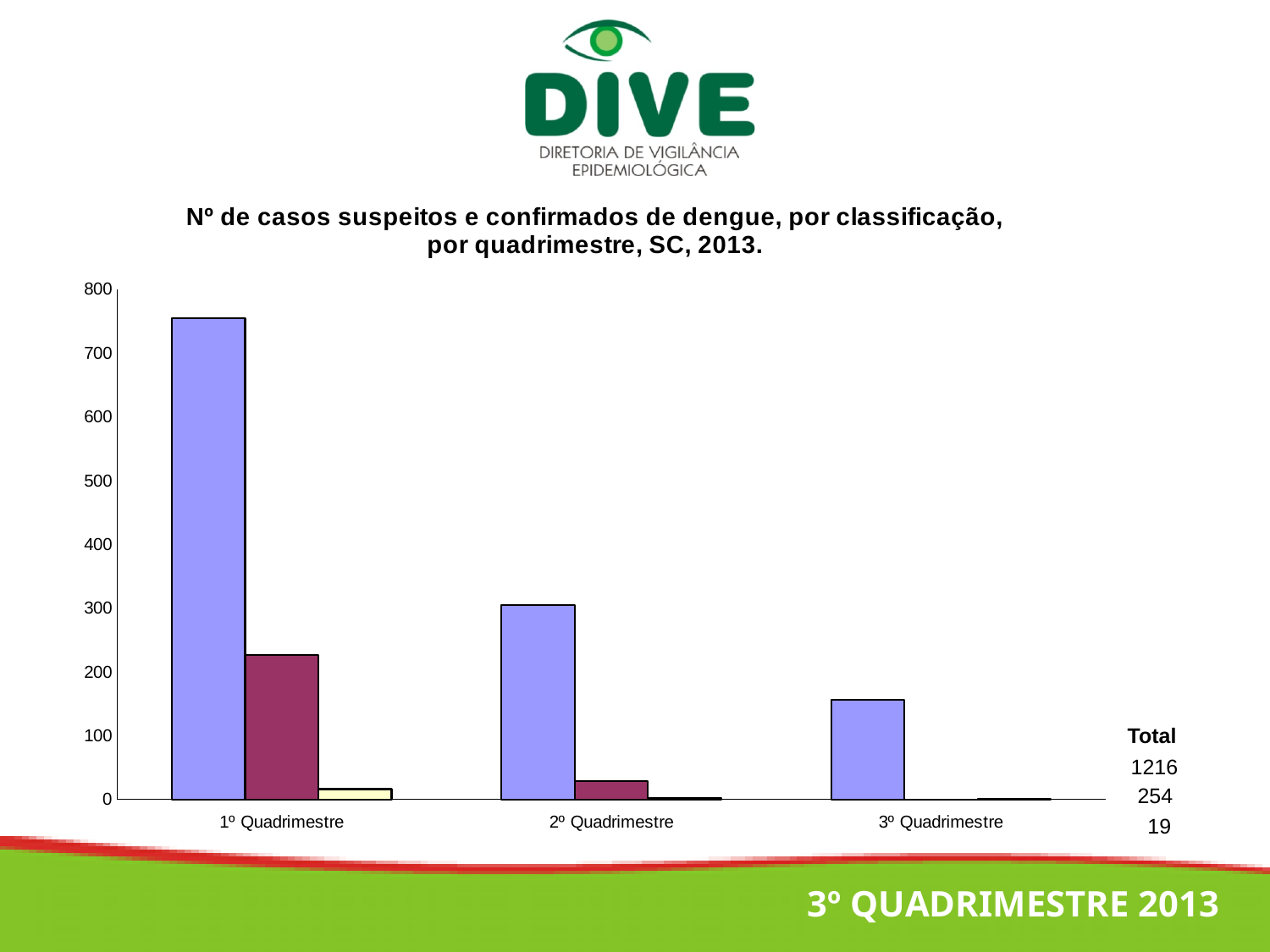
What is the title of the chart? Nº de casos suspeitos e confirmados de dengue, por classificação, por quadrimestre, SC, 2013. Is the value of the blue bar for 3º Quadrimestre greater or less than 200? less How many quadrimestre categories are shown on the x axis? 3 Do the blue bars rise or fall from 1º Quadrimestre to 3º Quadrimestre? fall Which quadrimestre has the tallest blue bar? 1º Quadrimestre Which is larger, the purple bar for 1º Quadrimestre or the blue bar for 3º Quadrimestre? purple bar for 1º Quadrimestre Is the value of the purple bar for 1º Quadrimestre greater or less than 200? greater Which is larger, the blue bar for 2º Quadrimestre or the blue bar for 3º Quadrimestre? 2º Quadrimestre Is the value of the blue bar for 2º Quadrimestre greater or less than 400? less What is the first value listed under the 'Total' label to the right of the chart? 1216 What kind of chart is shown on the slide? bar chart